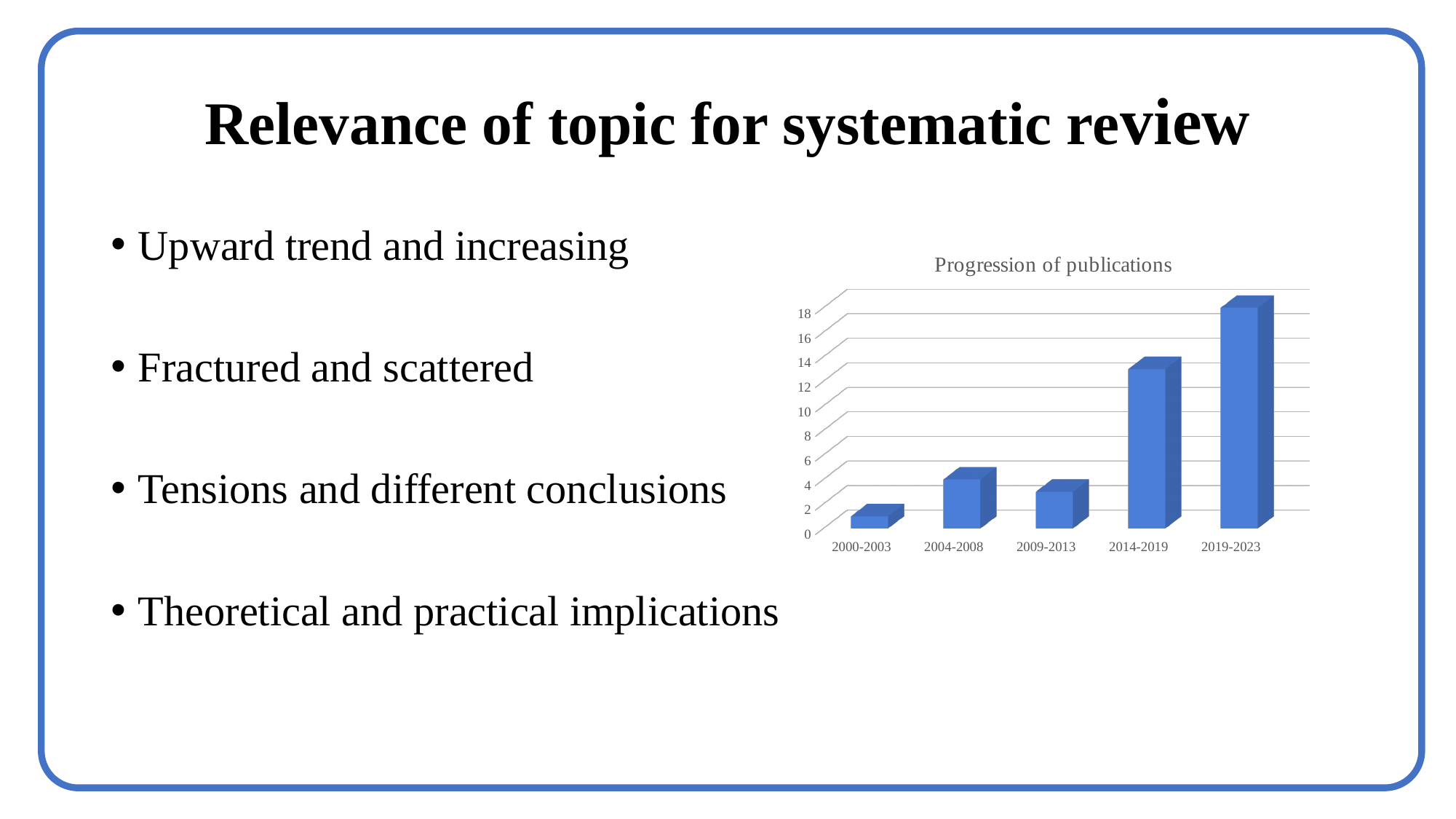
Is the value for 2000-2003 greater or less than 2? less Is the value for 2019-2023 greater or less than 16? greater How many time periods are shown on the x axis of the chart? 5 Is the value for 2009-2013 greater or less than 6? less Which period has more publications, 2019-2023 or 2014-2019? 2019-2023 Do the values generally rise or fall from 2000-2003 to 2019-2023? Rise Which period has the lowest number of publications? 2000-2003 Which period has more publications, 2014-2019 or 2009-2013? 2014-2019 What is the title of the chart? Progression of publications What type of chart is shown on the slide? Bar chart Which period has the highest number of publications? 2019-2023